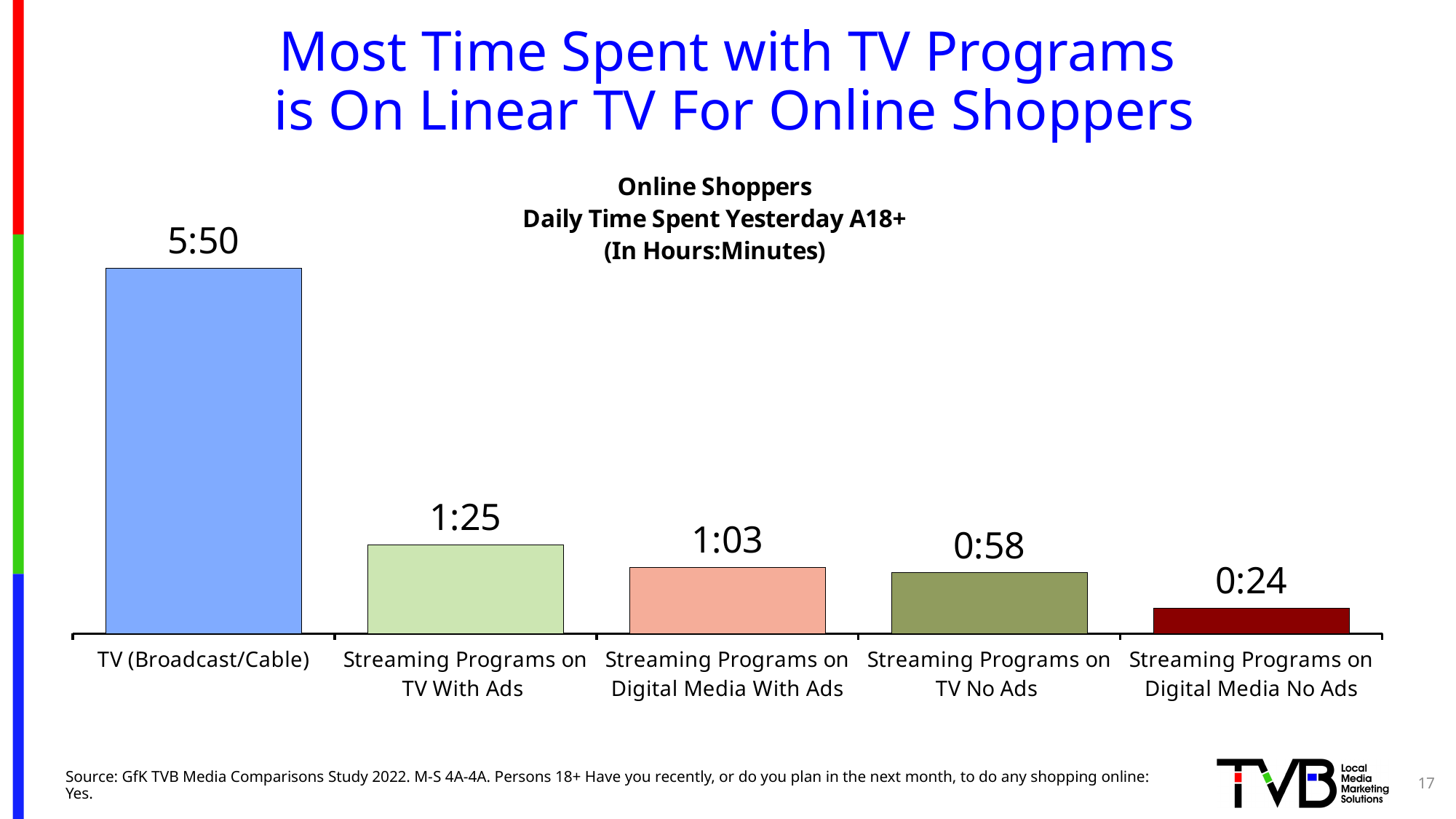
What is the daily time spent with TV (Broadcast/Cable) for online shoppers? 5:50 Which is larger: time spent with Streaming Programs on Digital Media With Ads or Streaming Programs on TV No Ads? Streaming Programs on Digital Media With Ads How much more time is spent with TV (Broadcast/Cable) than with Streaming Programs on TV With Ads? 4:25 How many categories are shown in the chart? 5 What is the daily time spent with Streaming Programs on Digital Media With Ads? 1:03 What is the daily time spent with Streaming Programs on TV With Ads? 1:25 What is the daily time spent with Streaming Programs on Digital Media No Ads? 0:24 Which category has the highest daily time spent? TV (Broadcast/Cable) In what units are the values in the chart expressed, according to the chart title? Hours:Minutes Which category has the lowest daily time spent? Streaming Programs on Digital Media No Ads What type of chart is shown on the slide? Bar chart What is the daily time spent with Streaming Programs on TV No Ads? 0:58